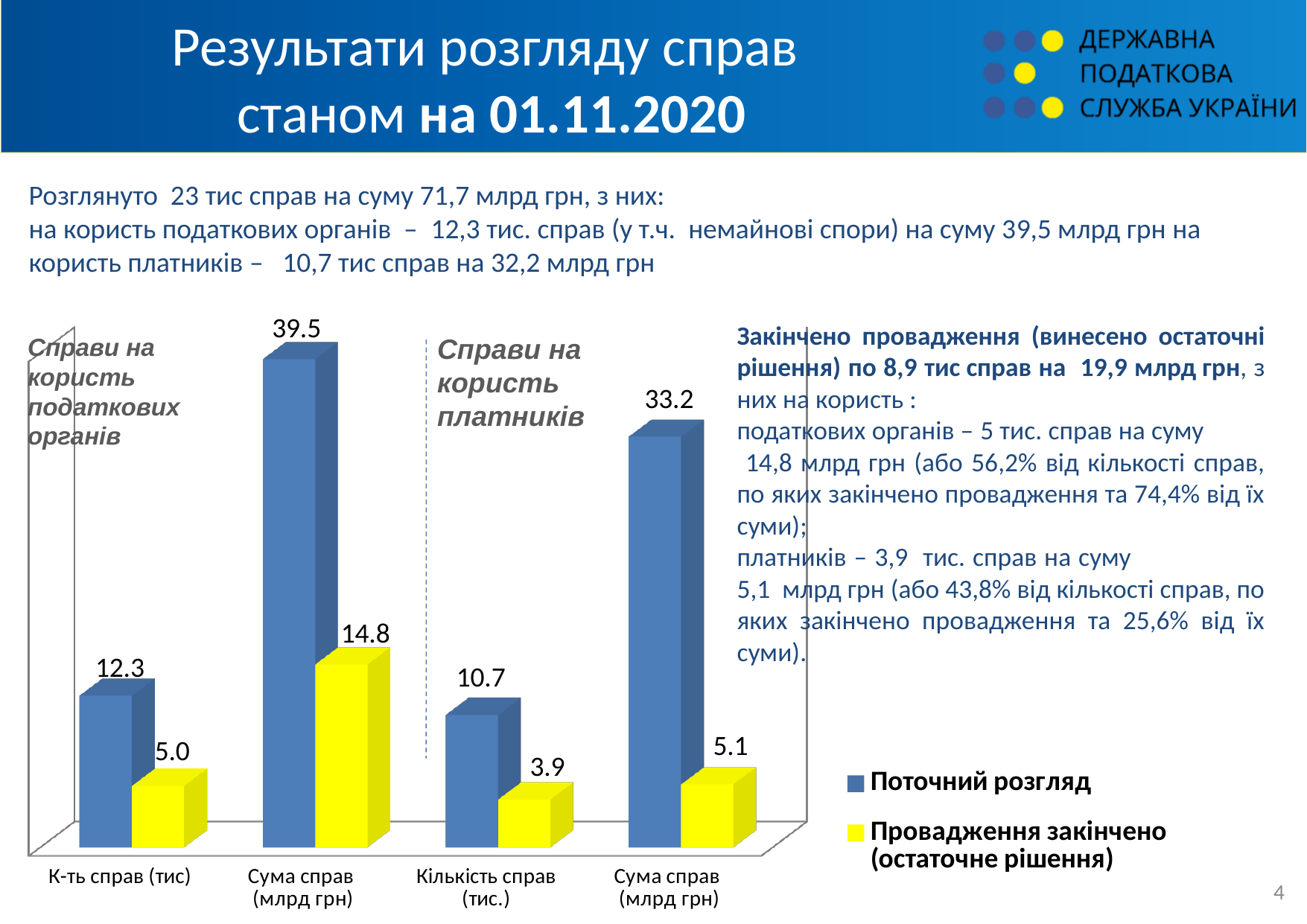
How many categories are shown along the x axis of the chart? 4 What type of chart is shown on the slide? bar chart Which series is shown in yellow in the chart? Провадження закінчено (остаточне рішення) Which category has the highest 'Поточний розгляд' value? Сума справ (млрд грн) in the 'Справи на користь податкових органів' group Which is larger: the 'Провадження закінчено (остаточне рішення)' value for 'К-ть справ (тис)' (податкових органів) or for 'Кількість справ (тис.)' (платників)? К-ть справ (тис) (податкових органів) What is the value of 'Провадження закінчено (остаточне рішення)' for 'Сума справ (млрд грн)' in the 'Справи на користь платників' group? 5.1 What is the value of 'Поточний розгляд' for 'Кількість справ (тис.)' in the 'Справи на користь платників' group? 10.7 How many series does the chart legend list? 2 What is the value of 'Провадження закінчено (остаточне рішення)' for 'Сума справ (млрд грн)' in the 'Справи на користь податкових органів' group? 14.8 Which category has the lowest 'Провадження закінчено (остаточне рішення)' value? Кількість справ (тис.) in the 'Справи на користь платників' group What is the difference between the 'Поточний розгляд' values for 'Сума справ (млрд грн)' in the 'податкових органів' group and in the 'платників' group? 6.3 What is the value of 'Поточний розгляд' for 'К-ть справ (тис)' in the 'Справи на користь податкових органів' group? 12.3